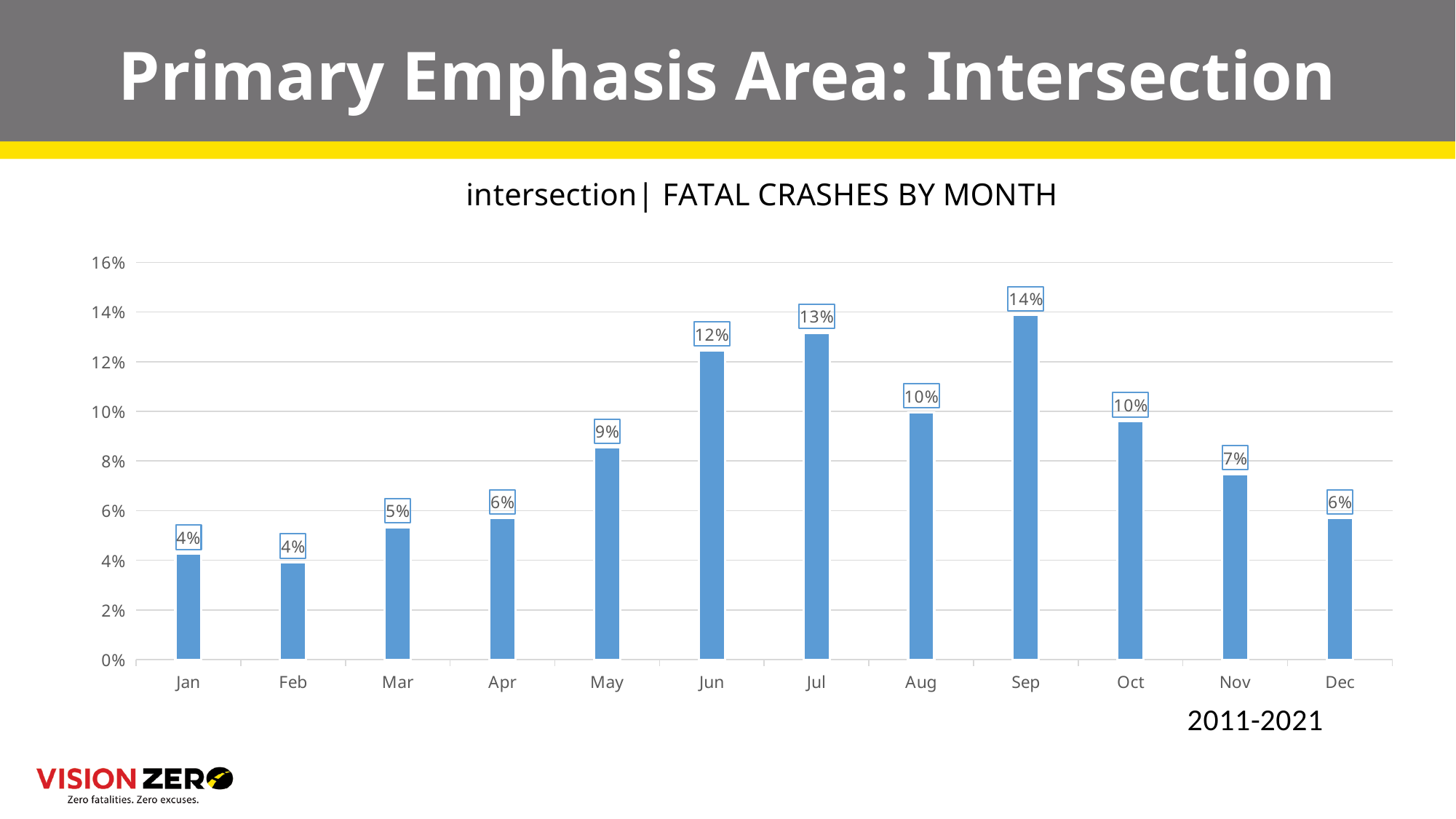
Is the value for Jul greater or less than 12%? greater Do the values rise or fall from Jan to Jul? Rise What is the title of the chart? intersection| FATAL CRASHES BY MONTH How many months are shown on the x axis? 12 What is the value for May? 9% Is the value for Feb greater or less than 6%? less Which is larger, the value for Jun or the value for Aug? Jun Which month has the highest share of fatal crashes? Sep What kind of chart is shown? Bar chart What is the value for Sep? 14% What is the value for Nov? 7% What is the difference between the values for Sep and Jan? 10%